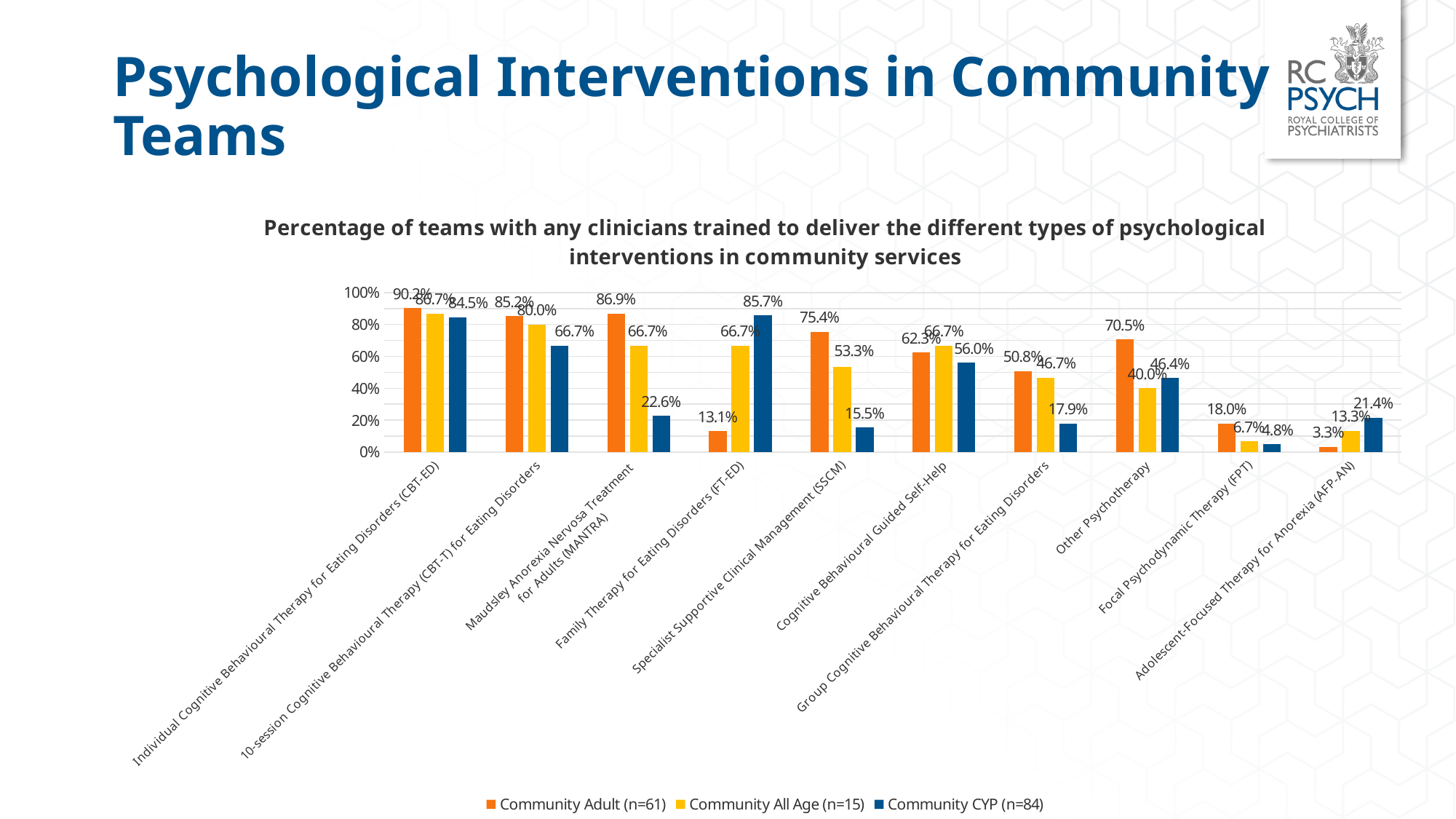
Which intervention has the lowest value for Community CYP (n=84)? Focal Psychodynamic Therapy (FPT) What is the value for Community All Age (n=15) for Specialist Supportive Clinical Management (SSCM)? 53.3% What percentage of Community Adult (n=61) teams have clinicians trained to deliver Maudsley Anorexia Nervosa Treatment for Adults (MANTRA)? 86.9% Which intervention has the highest value for Community Adult (n=61)? Individual Cognitive Behavioural Therapy for Eating Disorders (CBT-ED) What is the value for Community CYP (n=84) for Family Therapy for Eating Disorders (FT-ED)? 85.7% How many intervention categories are shown on the x axis? 10 Which colour represents Community CYP (n=84) in the chart? blue What is the difference between the Community Adult (n=61) and Community CYP (n=84) values for Specialist Supportive Clinical Management (SSCM)? 59.9% How many series does the legend list? 3 Is the Community Adult (n=61) value for Group Cognitive Behavioural Therapy for Eating Disorders greater or less than 40%? greater For Other Psychotherapy, which is larger: the Community All Age (n=15) value or the Community CYP (n=84) value? Community CYP (n=84) What kind of chart is shown on the slide? bar chart